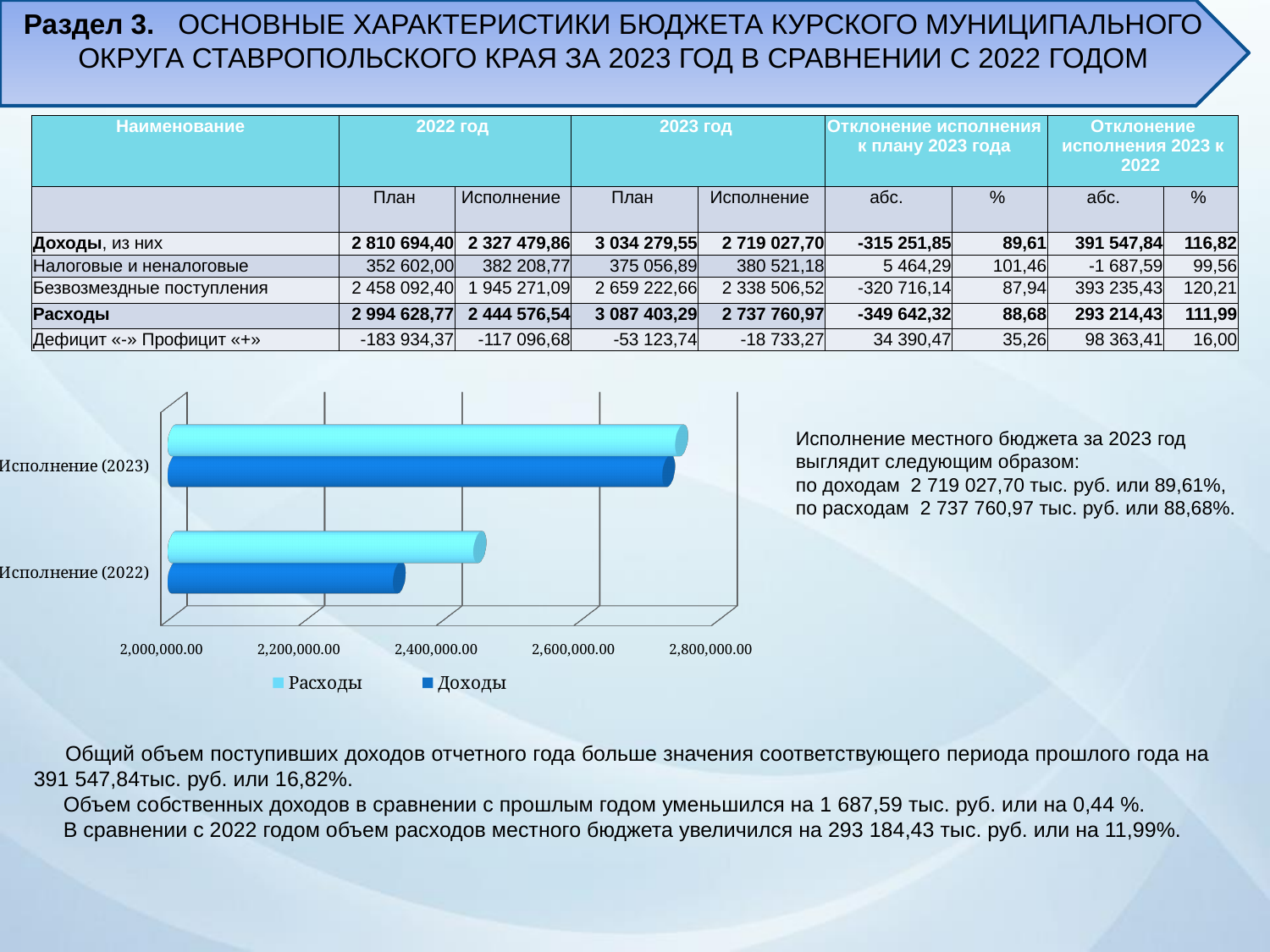
In the chart, is the value of Доходы for Исполнение (2022) greater or less than 2,200,000.00? greater In the chart, is the value of Доходы for Исполнение (2023) greater or less than 2,600,000.00? greater In the chart, is the value of Расходы for Исполнение (2023) greater or less than 2,600,000.00? greater Which two series are listed in the chart legend? Расходы and Доходы How many categories are shown on the chart's vertical axis? 2 In the chart, for Исполнение (2022), which series has the larger value: Расходы or Доходы? Расходы What kind of chart is shown on the slide? bar chart According to the chart, do the Расходы values rise or fall from Исполнение (2022) to Исполнение (2023)? rise Which series is drawn in the lighter blue colour in the chart? Расходы How many series does the chart legend list? 2 In the chart, is the Доходы value for Исполнение (2023) larger or smaller than the Доходы value for Исполнение (2022)? larger